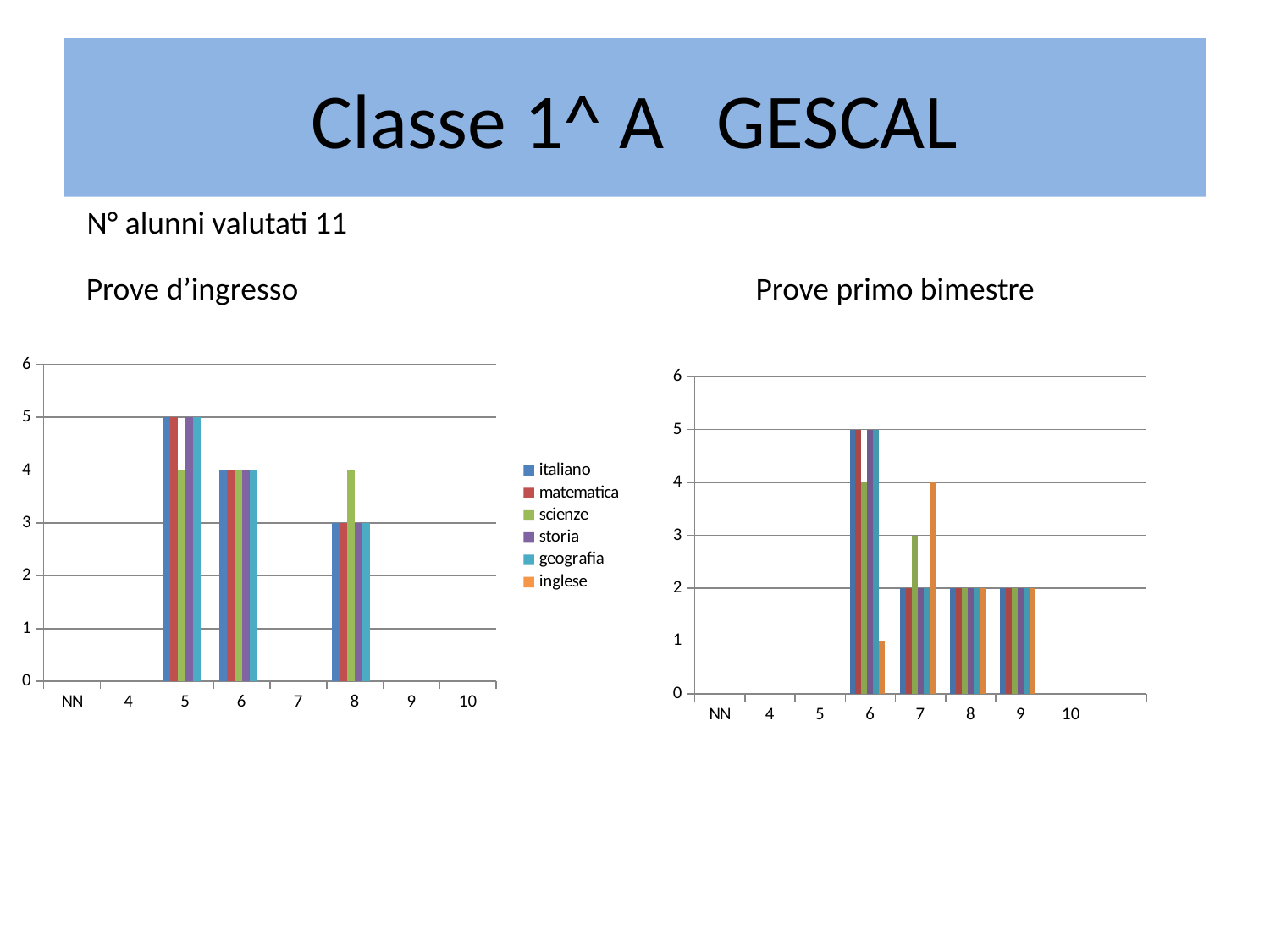
What kind of chart is the 'Prove d'ingresso' chart? bar chart In the 'Prove d'ingresso' chart, which series has the highest value at category 8? scienze In the 'Prove d'ingresso' chart, is the italiano value at category 5 larger or smaller than the italiano value at category 6? larger How many series does the legend list? 6 In the 'Prove primo bimestre' chart, which series has the lowest value at category 6? inglese How many categories are shown on the x axis of the 'Prove primo bimestre' chart? 8 In the 'Prove primo bimestre' chart, what is the value for scienze at category 7? 3 In the 'Prove primo bimestre' chart, what is the value for inglese at category 6? 1 In the 'Prove d'ingresso' chart, what is the value for scienze at category 5? 4 In the 'Prove primo bimestre' chart, what is the difference between the inglese value at category 7 and the inglese value at category 6? 3 In the 'Prove d'ingresso' chart, what is the value for italiano at category 8? 3 In the 'Prove primo bimestre' chart, what is the value for inglese at category 7? 4